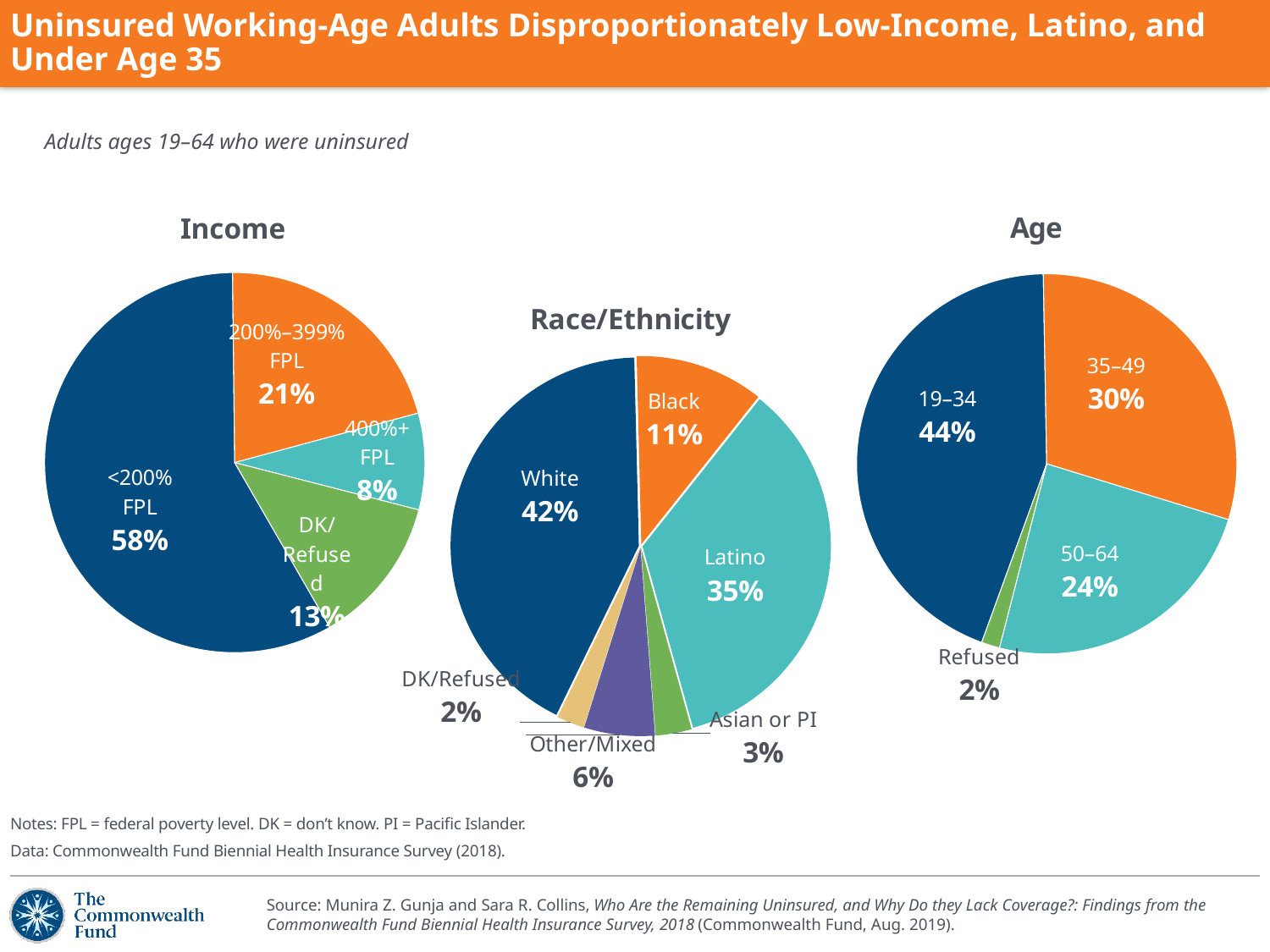
In the Income pie chart, what is the difference between the 200%–399% FPL share and the DK/Refused share? 8 percentage points In the Race/Ethnicity pie chart, what share is Latino? 35% In the Race/Ethnicity pie chart, which is larger, the Black share or the Other/Mixed share? Black In the Age pie chart, what share of uninsured adults were ages 50–64? 24% In the Race/Ethnicity pie chart, how many categories are shown? 6 What type of chart is used for the Income, Race/Ethnicity, and Age breakdowns? Pie chart In the Age pie chart, which age group has the largest share? 19–34 In the Race/Ethnicity pie chart, which group has the largest share? White In the Age pie chart, what is the difference between the 19–34 share and the 35–49 share? 14 percentage points In the Income pie chart, what share of uninsured adults had income below 200% FPL? 58% How many pie charts are on the slide? 3 In the Income pie chart, which income category has the smallest share? 400%+ FPL